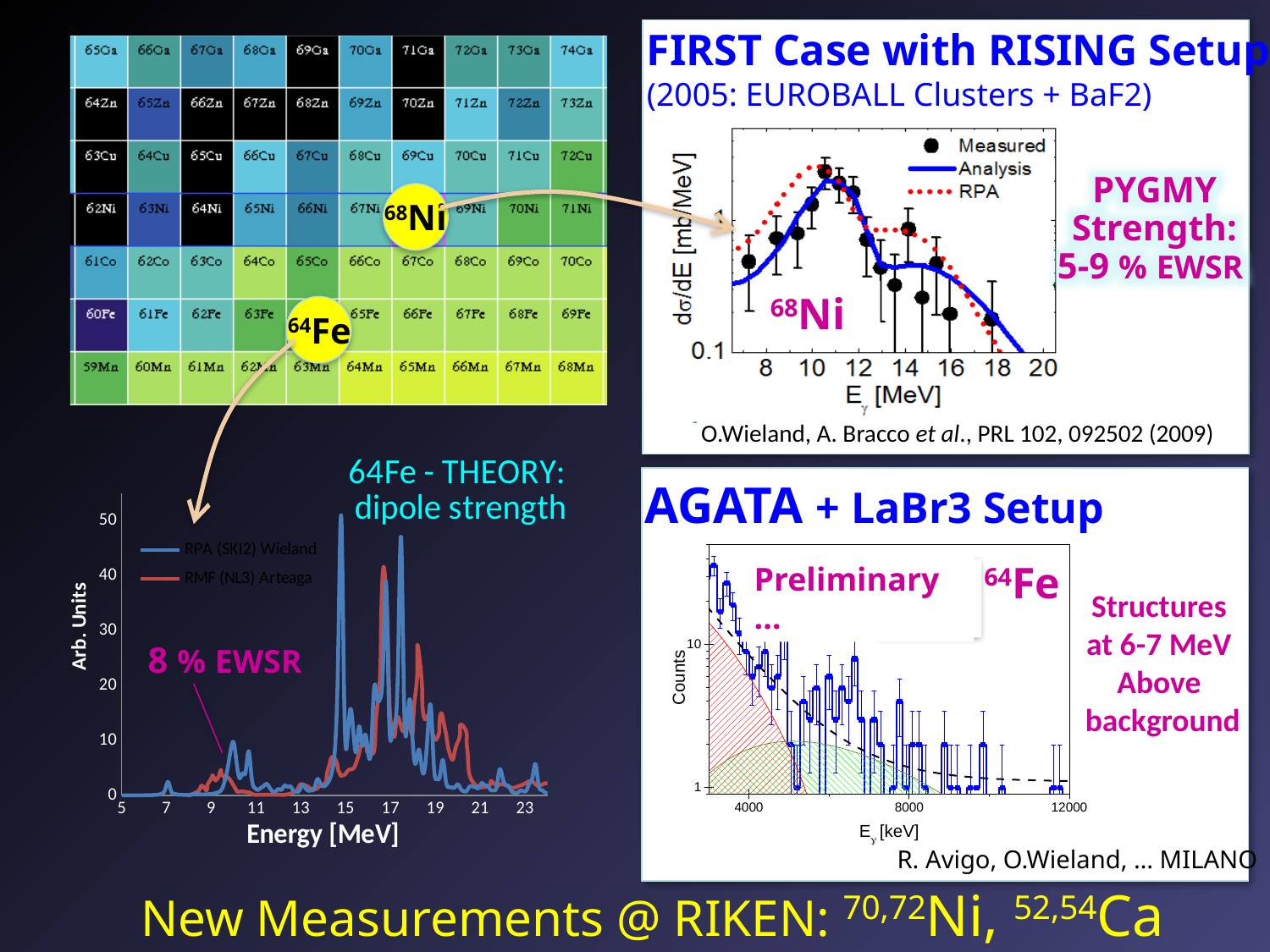
In the bottom-right chart (AGATA + LaBr3 Setup, 64Fe), do the counts generally rise or fall as the energy increases from 4000 to 12000 keV? fall In the top-right chart (68Ni cross section), how many entries does the legend list? 3 In the top-right chart (68Ni cross section), which legend entry is drawn as a red dotted line? RPA What kind of chart is the bottom-left chart (64Fe - THEORY: dipole strength)? line chart In the bottom-right chart (AGATA + LaBr3 Setup), which nucleus is labelled on the plot? 64Fe In the bottom-left chart (64Fe - THEORY: dipole strength), what is the x-axis label? Energy [MeV] In the bottom-left chart (64Fe - THEORY: dipole strength), which series reaches the highest peak value? RPA (SKI2) Wieland In the bottom-left chart (64Fe - THEORY: dipole strength), is the value of the RMF (NL3) Arteaga series at 7 MeV greater or less than 10? less In the bottom-left chart (64Fe - THEORY: dipole strength), how many series does the legend list? 2 In the bottom-left chart (64Fe - THEORY: dipole strength), is the highest peak of the RPA (SKI2) Wieland series greater or less than 40? greater